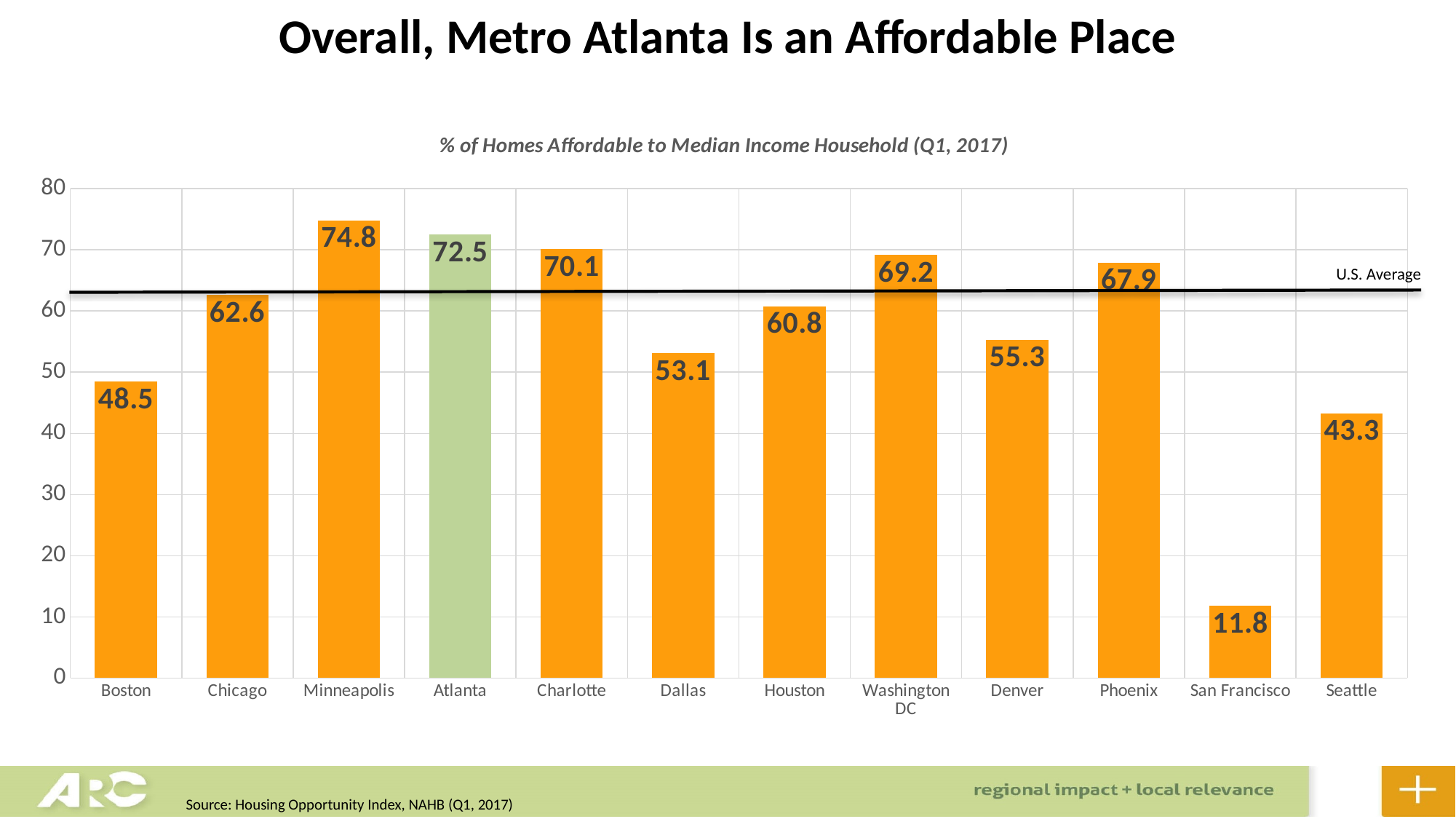
Which city has the lowest percentage of homes affordable to a median income household? San Francisco What is the value for Washington DC? 69.2 Which city has the highest percentage of homes affordable to a median income household? Minneapolis What is the difference between the values for Minneapolis and Atlanta? 2.3 What is the value for San Francisco? 11.8 Which has a higher value, Charlotte or Phoenix? Charlotte What is the value for Atlanta? 72.5 What does the horizontal black line across the chart represent? U.S. Average What type of chart is shown on the slide? bar chart What is the difference between the values for Seattle and San Francisco? 31.5 Is the value for Denver greater or less than 60? less How many cities are shown in the chart? 12